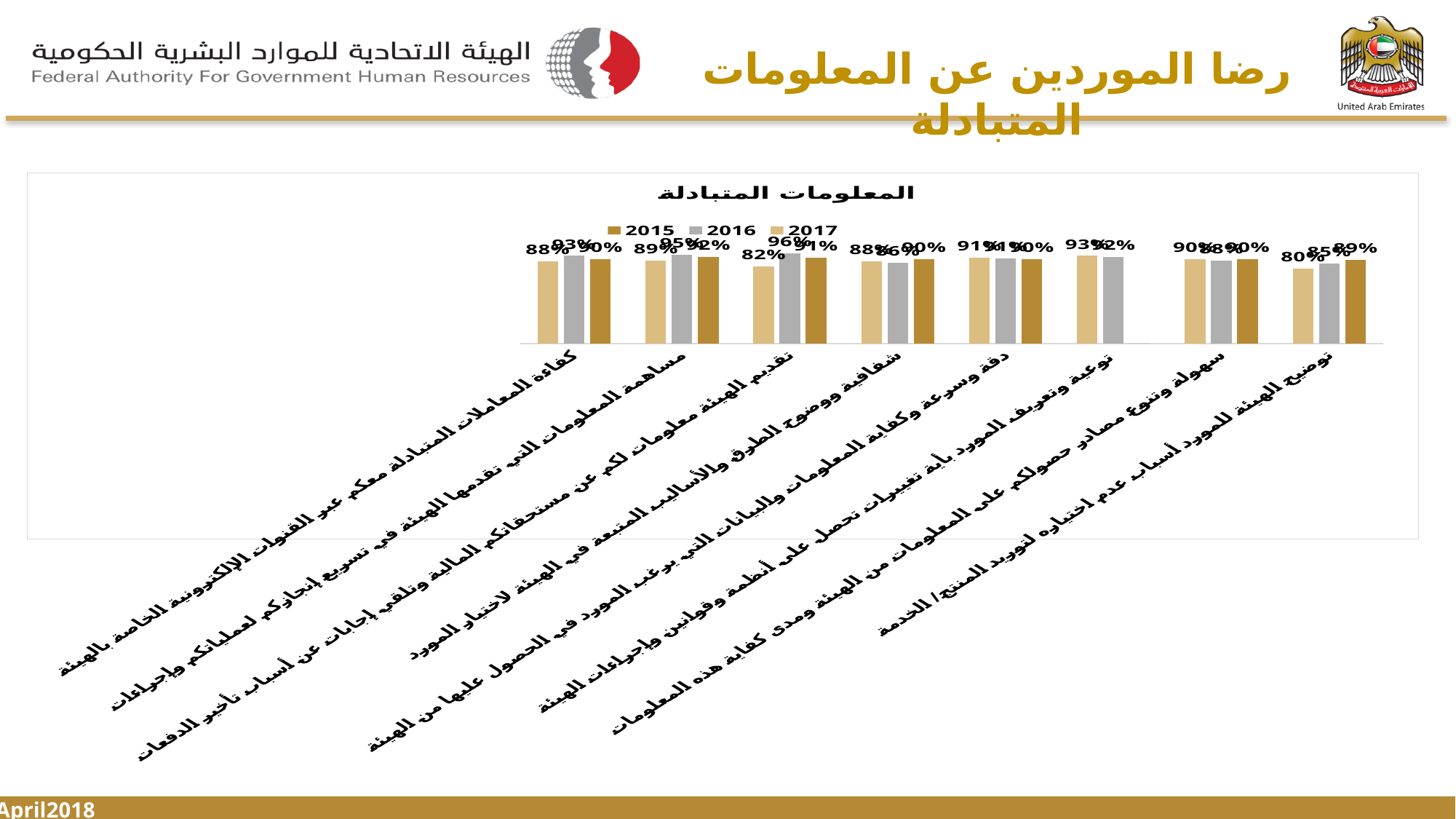
What is the 2016 value for the category 'تقديم الهيئة معلومات لكم عن مستحقاتكم المالية وتلقي إجابات عن أسباب تأخير الدفعات'? 96% What is the lowest value labelled anywhere on the chart? 80% What are the entries in the chart legend? 2015, 2016, 2017 What is the title of the chart? المعلومات المتبادلة What type of chart is shown on the slide? bar chart What is the highest value labelled anywhere on the chart? 96% What is the 2016 value for the category 'توضيح الهيئة للمورد أسباب عدم اختياره لتوريد المنتج / الخدمة'? 85% How many series does the chart legend list? 3 How many bars are plotted for the category 'توعية وتعريف المورد بأية تغييرات تحصل على أنظمة وقوانين وإجراءات الهيئة'? 2 What is the 2016 value for the category 'مساهمة المعلومات التي تقدمها الهيئة في تسريع إنجازكم لعملياتكم وإجراءاتكم'? 95% Which has the larger 2016 value: 'تقديم الهيئة معلومات لكم عن مستحقاتكم المالية وتلقي إجابات عن أسباب تأخير الدفعات' or 'توضيح الهيئة للمورد أسباب عدم اختياره لتوريد المنتج / الخدمة'? تقديم الهيئة معلومات لكم عن مستحقاتكم المالية وتلقي إجابات عن أسباب تأخير الدفعات How many categories are shown along the x axis of the chart? 8